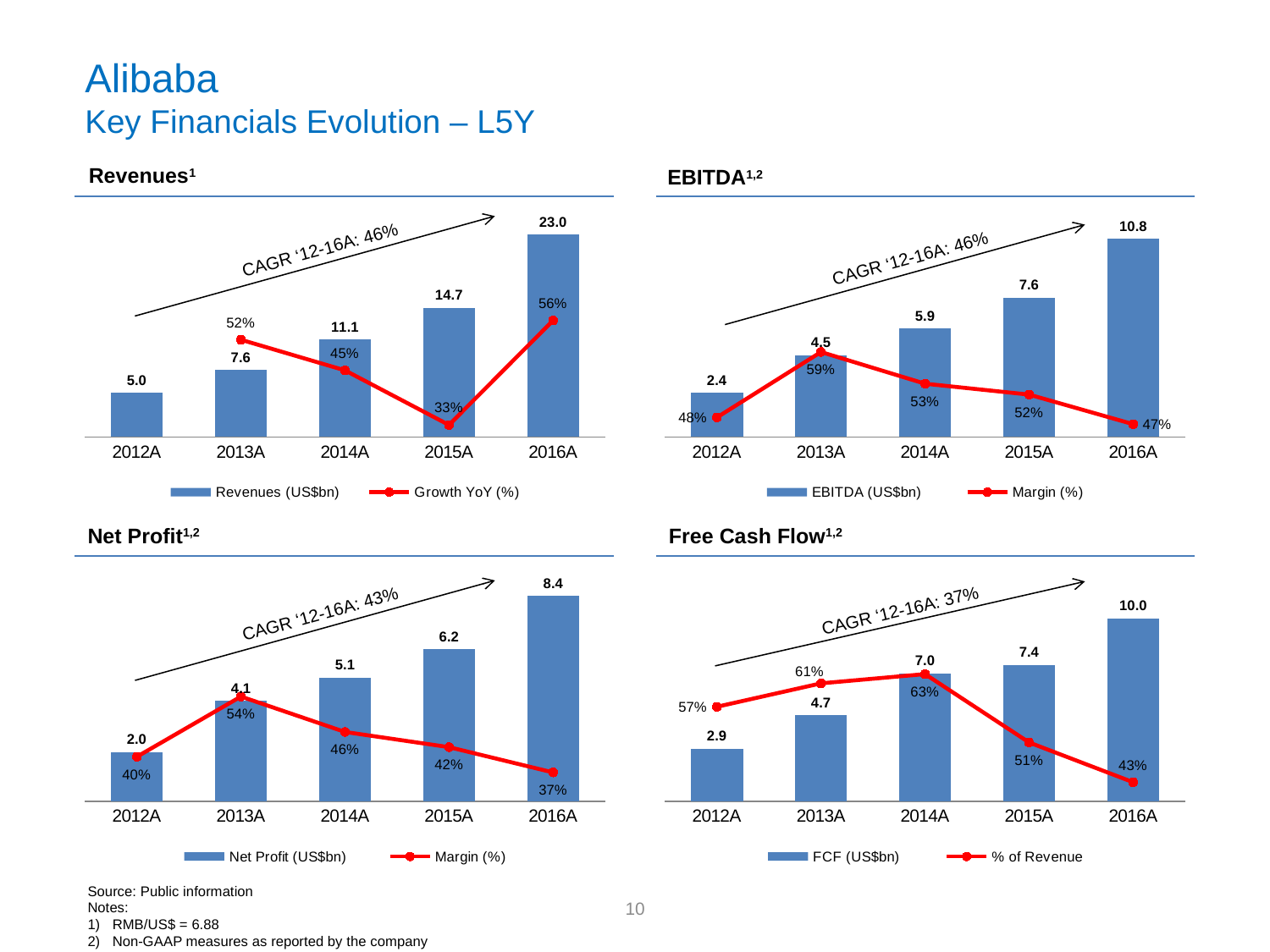
In the Free Cash Flow chart, do the FCF bar values rise or fall from 2012A to 2016A? rise In the Free Cash Flow chart, is the % of Revenue larger in 2014A or 2016A? 2014A What CAGR '12-16A is shown on the Net Profit chart? 43% In the Revenues chart, what is the revenue value for 2016A? 23.0 How many years are shown on the x axis of the Revenues chart? 5 In the Net Profit chart, which year has the lowest margin? 2016A How many series does the legend of the EBITDA chart list? 2 In the Revenues chart, what is the Growth YoY value for 2015A? 33% In the Free Cash Flow chart, what is the FCF value for 2013A? 4.7 In the EBITDA chart, what is the EBITDA value for 2014A? 5.9 In the EBITDA chart, which year has the highest margin? 2013A In the Net Profit chart, what is the difference between the net profit for 2016A and 2015A? 2.2